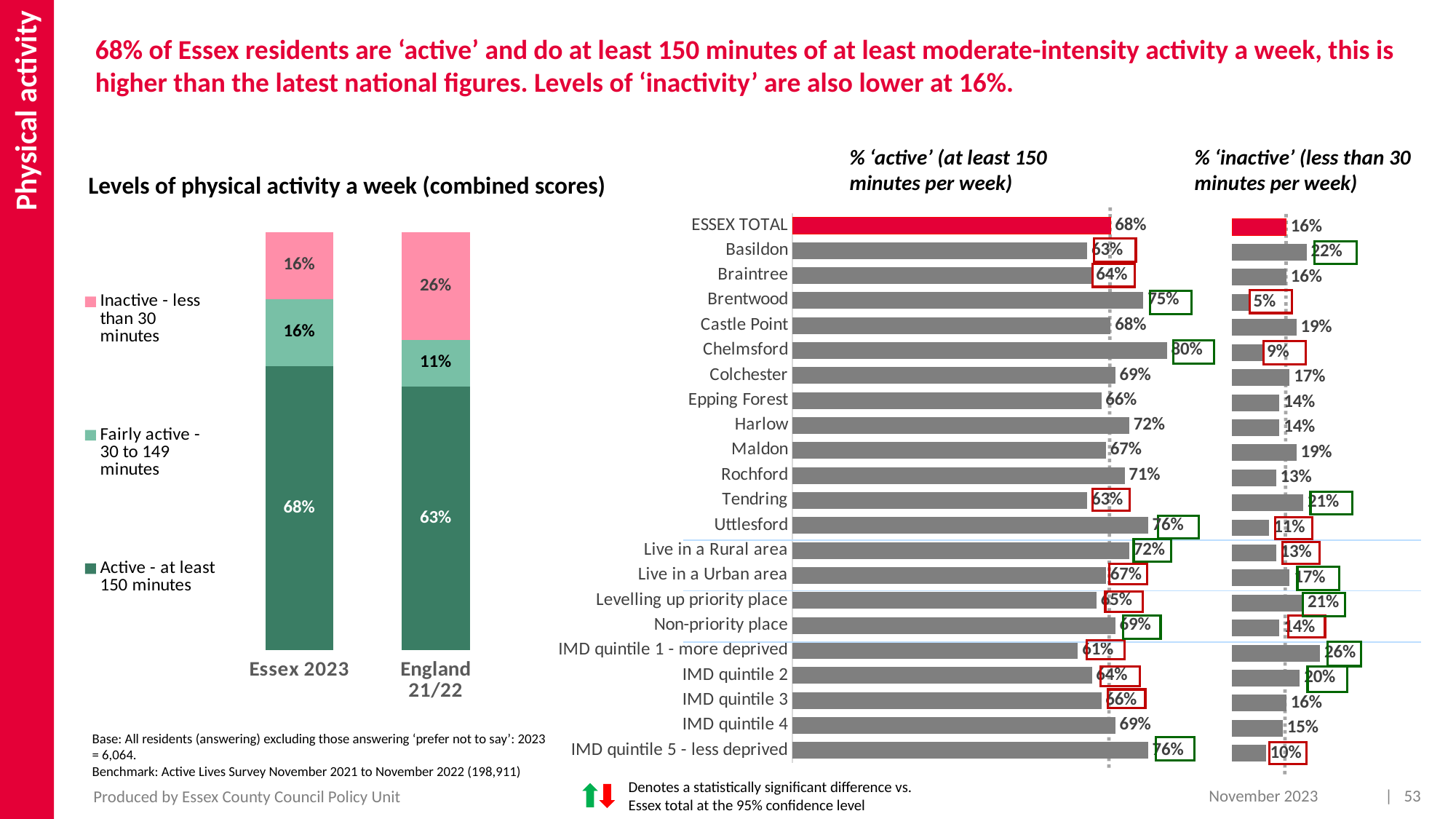
In the '% inactive (less than 30 minutes per week)' chart, which category has the lowest value? Brentwood In the '% active (at least 150 minutes per week)' chart, what is the value for Uttlesford? 76% How many categories are plotted in the '% active (at least 150 minutes per week)' chart? 22 In the 'Levels of physical activity a week (combined scores)' chart, what is the difference between the 'Fairly active' values for Essex 2023 and England 21/22? 5 percentage points In the 'Levels of physical activity a week (combined scores)' chart, what is the 'Inactive - less than 30 minutes' value for England 21/22? 26% In the '% inactive (less than 30 minutes per week)' chart, what is the value for Basildon? 22% In the '% inactive (less than 30 minutes per week)' chart, which is larger: Tendring or Rochford? Tendring What kind of chart is 'Levels of physical activity a week (combined scores)'? Stacked bar chart In the '% active (at least 150 minutes per week)' chart, which category has the lowest value? IMD quintile 1 - more deprived In the '% active (at least 150 minutes per week)' chart, which category has the highest value? Chelmsford In the 'Levels of physical activity a week (combined scores)' chart, how many series does the legend list? 3 In the 'Levels of physical activity a week (combined scores)' chart, what percentage of Essex 2023 residents are 'Active - at least 150 minutes'? 68%